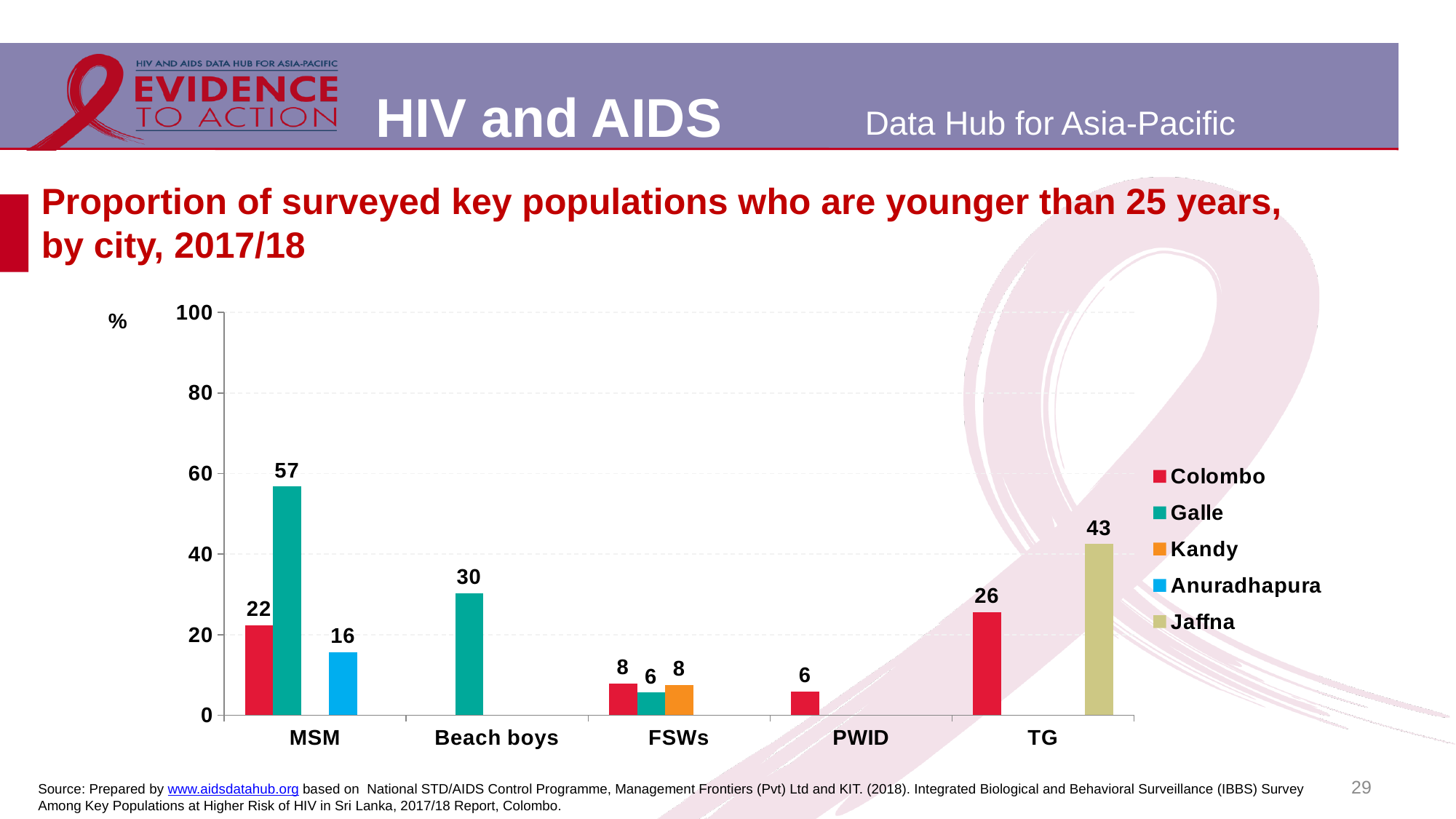
Which city has the lowest value in the FSWs category? Galle What is the value for Galle in the Beach boys category? 30 What kind of chart is shown on the slide? Bar chart How many series does the legend list? 5 Which is larger in the TG category: Colombo or Jaffna? Jaffna What is the value for Anuradhapura in the MSM category? 16 What is the value for Colombo in the PWID category? 6 How many categories are shown on the x axis? 5 What is the difference between the Galle and Colombo values in the MSM category? 35 What is the value for Galle in the MSM category? 57 What is the value for Jaffna in the TG category? 43 Which city has the highest value in the MSM category? Galle